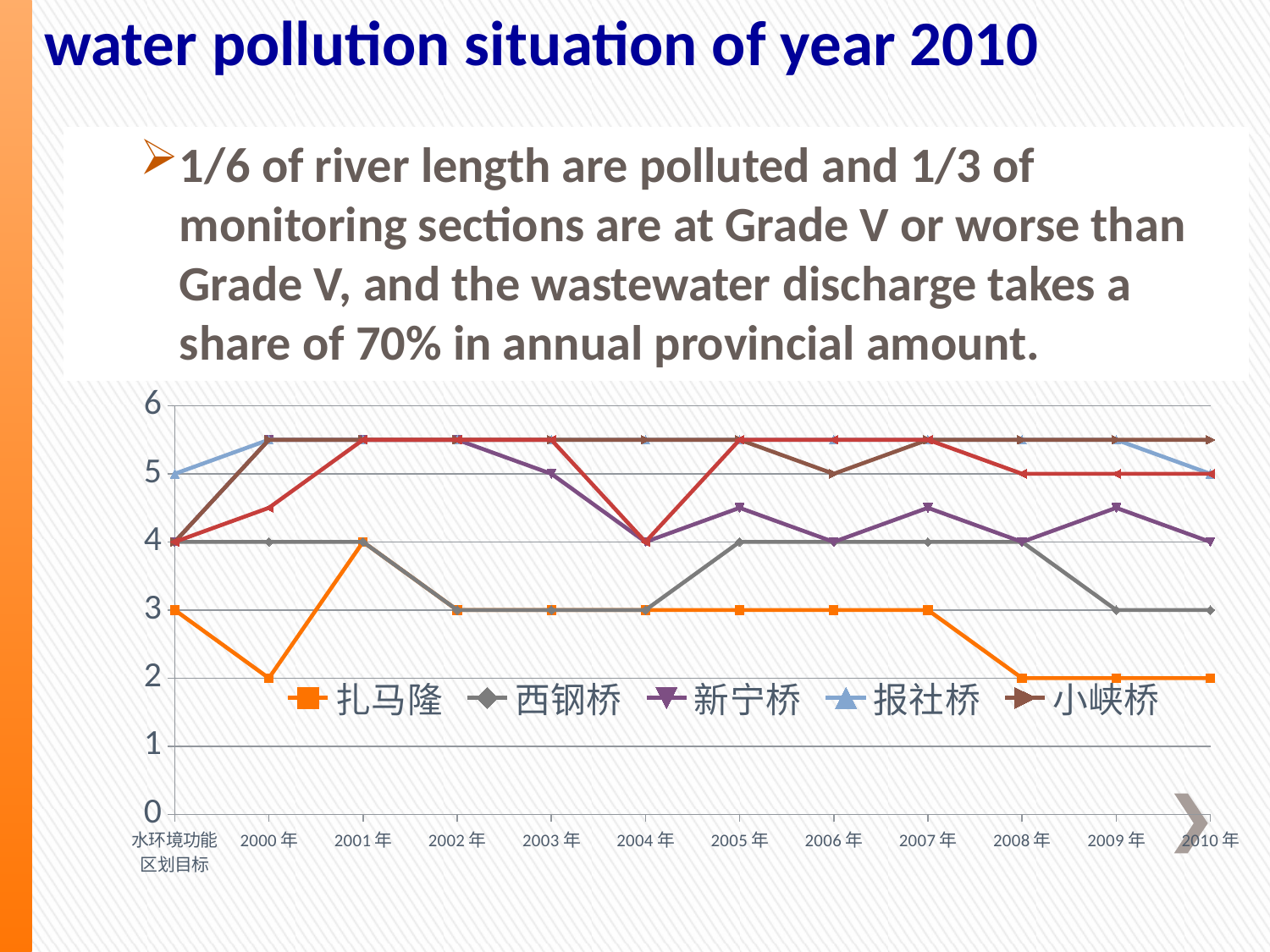
Which series has the lowest value in 2010年? 扎马隆 By how much does the value for 扎马隆 change from 2000年 to 2001年? 2 In 2000年, which is larger: the value for 扎马隆 or the value for 西钢桥? 西钢桥 What type of chart is shown on the slide? line chart What is the value for 西钢桥 in 2002年? 3 What is the value for 扎马隆 in 2001年? 4 What is the value for 新宁桥 in 2010年? 4 What is the value for 扎马隆 in 2000年? 2 How many categories are shown along the x axis of the chart? 12 Does the value for 扎马隆 rise or fall from 2007年 to 2008年? fall Is the value for 报社桥 in 2005年 greater or less than 5? greater How many series does the chart legend list? 5